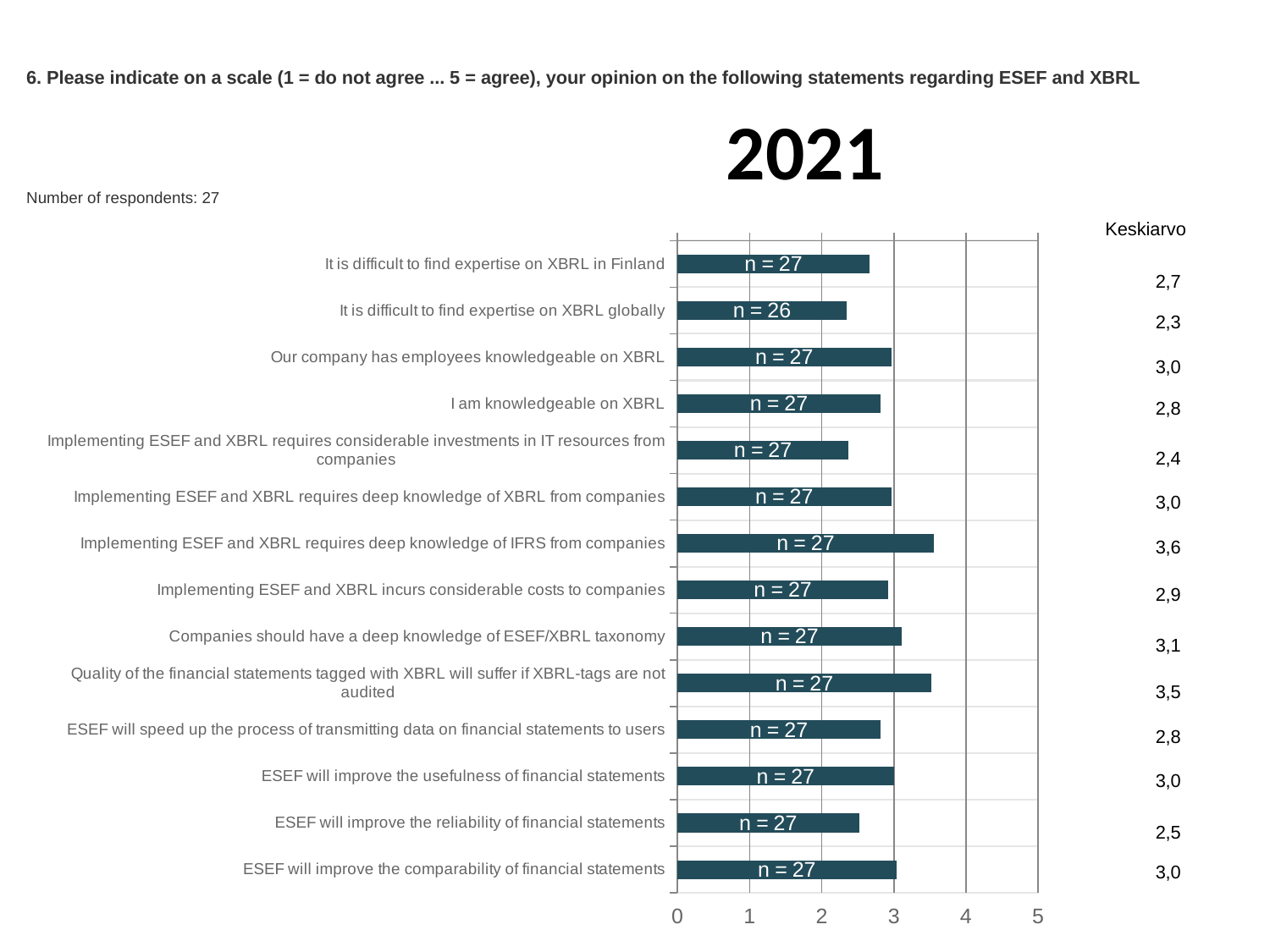
What is the n value shown on the bar for "It is difficult to find expertise on XBRL globally"? n = 26 Which statement has the highest Keskiarvo value? Implementing ESEF and XBRL requires deep knowledge of IFRS from companies What is the Keskiarvo value for "ESEF will improve the reliability of financial statements"? 2,5 What is the difference between the highest Keskiarvo value (3,6) and the lowest (2,3)? 1,3 What kind of chart is shown on the slide? bar chart What is the Keskiarvo value for "Quality of the financial statements tagged with XBRL will suffer if XBRL-tags are not audited"? 3,5 What is the Keskiarvo (mean) value for "Implementing ESEF and XBRL requires deep knowledge of IFRS from companies"? 3,6 How many statements (categories) are plotted in the chart? 14 What is the Keskiarvo value for "It is difficult to find expertise on XBRL globally"? 2,3 Is the value for "Implementing ESEF and XBRL requires considerable investments in IT resources from companies" greater or less than 3? less Which has a larger Keskiarvo value: "Implementing ESEF and XBRL requires deep knowledge of IFRS from companies" or "Implementing ESEF and XBRL requires deep knowledge of XBRL from companies"? Implementing ESEF and XBRL requires deep knowledge of IFRS from companies Which statement has the lowest Keskiarvo value? It is difficult to find expertise on XBRL globally